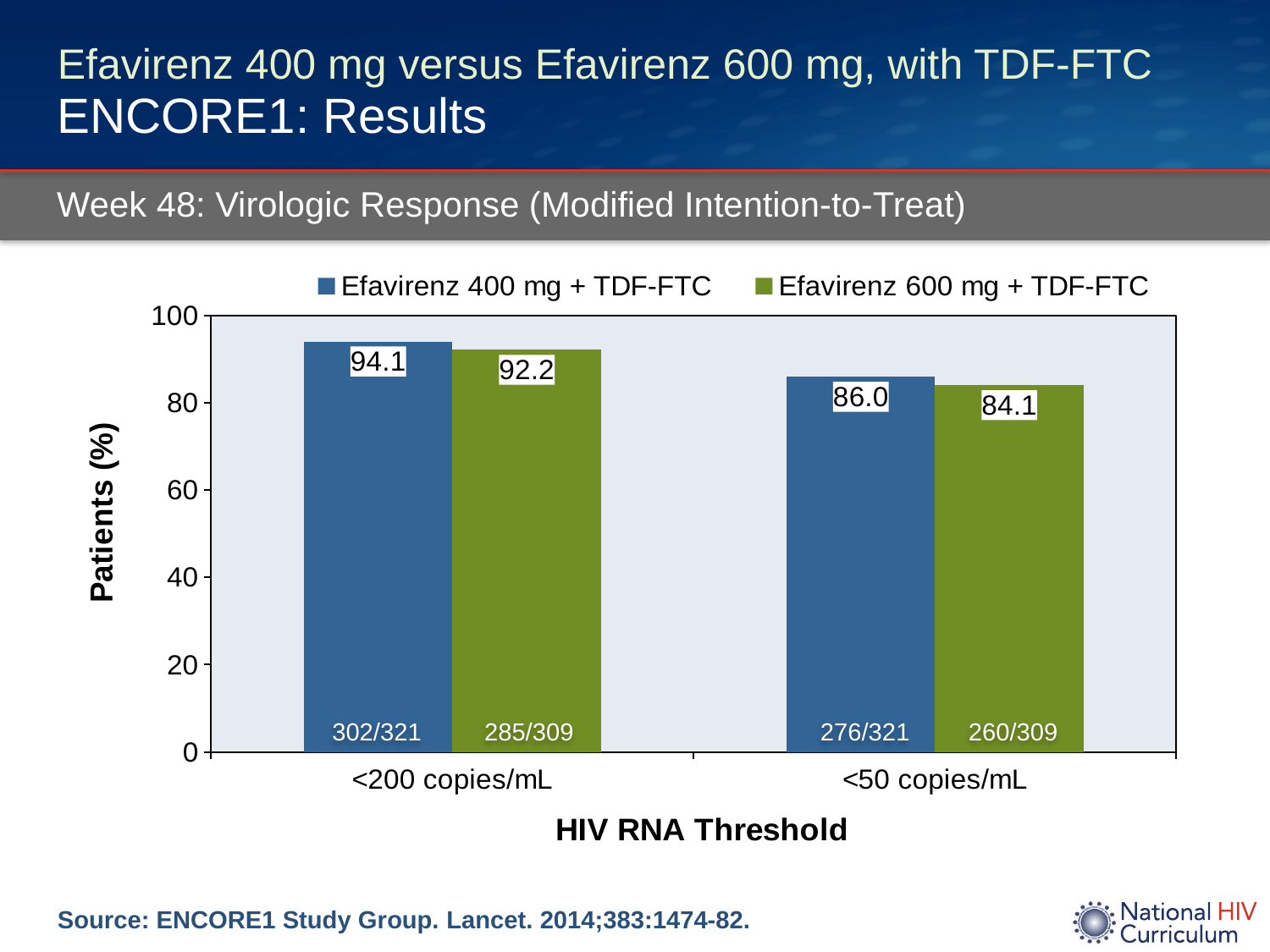
Is the value for Efavirenz 600 mg + TDF-FTC at <50 copies/mL greater or less than 80? greater What is the difference between the Efavirenz 400 mg + TDF-FTC and Efavirenz 600 mg + TDF-FTC values at the <50 copies/mL threshold? 1.9 Which bar has the lowest value on the chart? Efavirenz 600 mg + TDF-FTC at <50 copies/mL Which bar has the highest value on the chart? Efavirenz 400 mg + TDF-FTC at <200 copies/mL What fraction of patients is shown inside the Efavirenz 400 mg + TDF-FTC bar at the <50 copies/mL threshold? 276/321 How many series does the legend list? 2 What is the value for Efavirenz 600 mg + TDF-FTC at the <200 copies/mL threshold? 92.2 At the <200 copies/mL threshold, which series has the larger value, Efavirenz 400 mg + TDF-FTC or Efavirenz 600 mg + TDF-FTC? Efavirenz 400 mg + TDF-FTC What kind of chart is shown on the slide? Bar chart How many HIV RNA threshold categories are shown on the x axis? 2 What is the value for Efavirenz 600 mg + TDF-FTC at the <50 copies/mL threshold? 84.1 What is the value for Efavirenz 400 mg + TDF-FTC at the <200 copies/mL threshold? 94.1